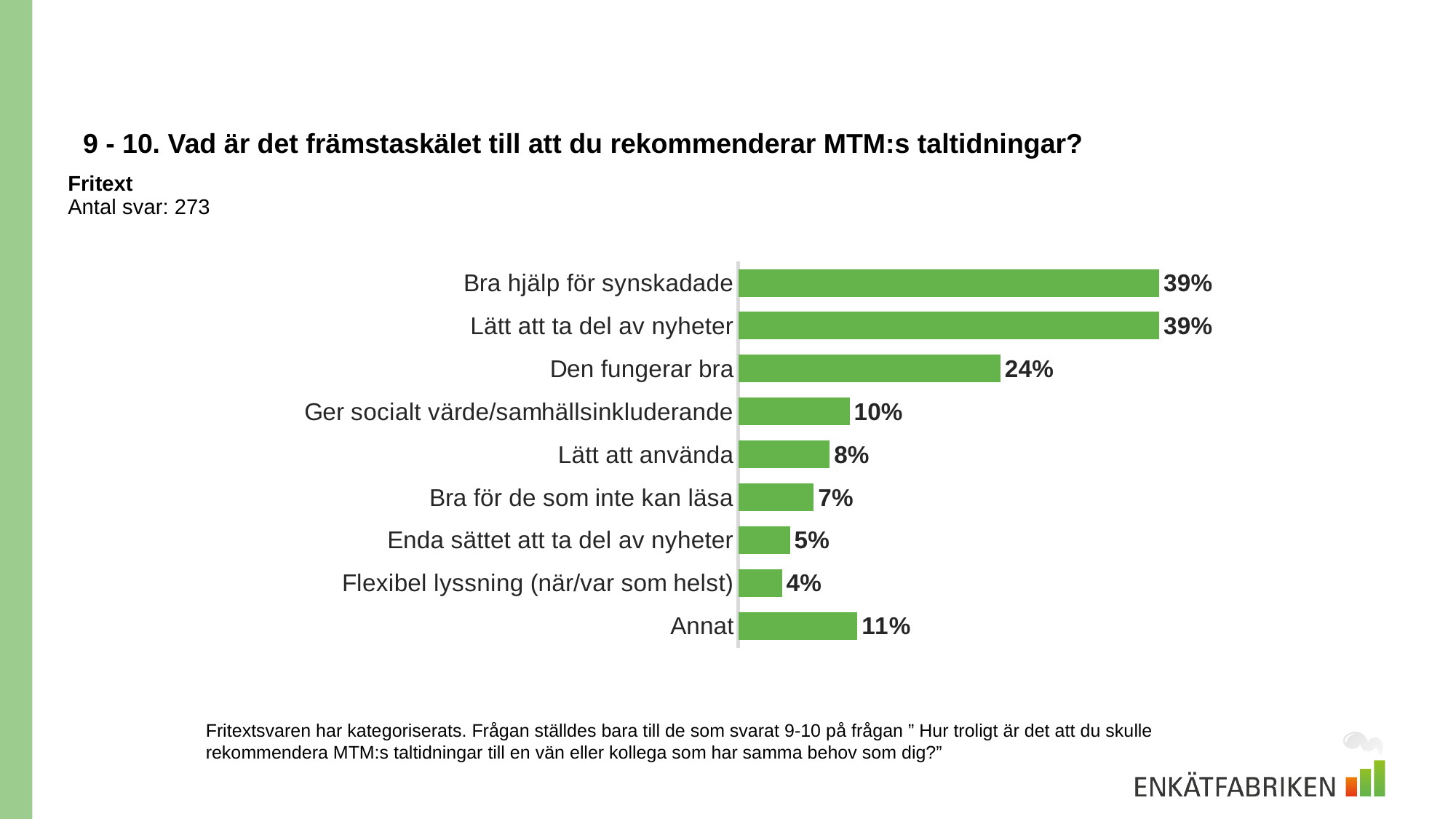
What is the difference in percentage points between "Bra hjälp för synskadade" and "Den fungerar bra"? 15 What is the difference in percentage points between "Annat" and "Lätt att använda"? 3 What kind of chart is shown on the slide? Bar chart What percentage is shown for "Annat"? 11% Which is larger, the value for "Annat" or the value for "Ger socialt värde/samhällsinkluderande"? Annat What is the value for "Enda sättet att ta del av nyheter"? 5% How many categories are shown in the chart? 9 What is the value shown for "Ger socialt värde/samhällsinkluderande"? 10% What percentage of respondents gave "Den fungerar bra" as their main reason? 24% Which is larger, the value for "Lätt att använda" or the value for "Bra för de som inte kan läsa"? Lätt att använda Which category has the lowest percentage? Flexibel lyssning (när/var som helst) How many responses (Antal svar) does the slide report for this question? 273